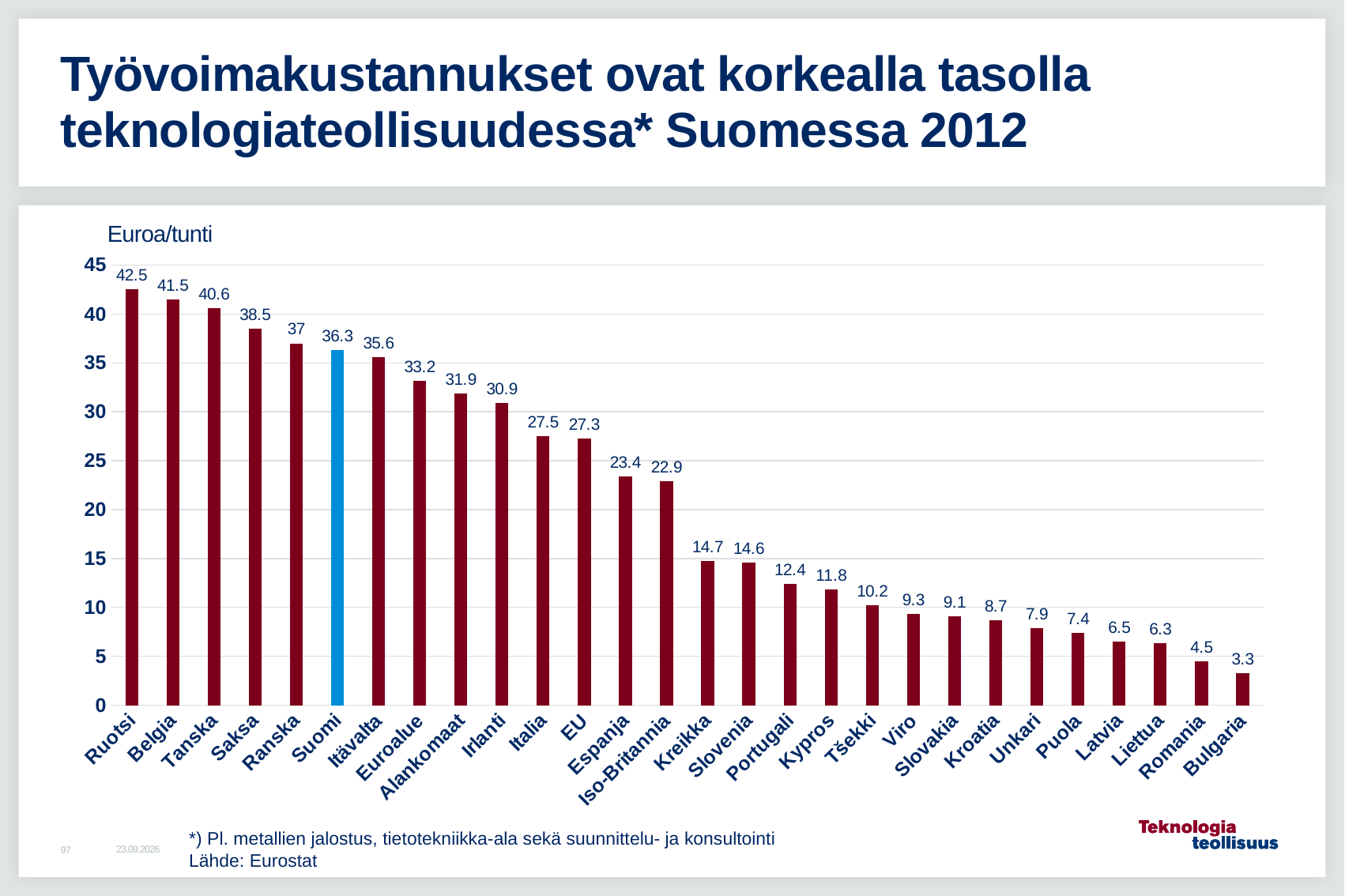
What is the difference between the values for Ruotsi and Suomi? 6.2 Which country has the highest value? Ruotsi Which country has the lowest value? Bulgaria What kind of chart is shown on the slide? Bar chart What is the value for Iso-Britannia? 22.9 Which has a larger value, Espanja or Kreikka? Espanja Is the value for Italia greater or less than 25? greater What unit is shown above the y axis of the chart? Euroa/tunti What is the value for Saksa? 38.5 What is the difference between the values for Euroalue and EU? 5.9 How many countries or regions are shown on the chart? 28 What is the value for Suomi? 36.3